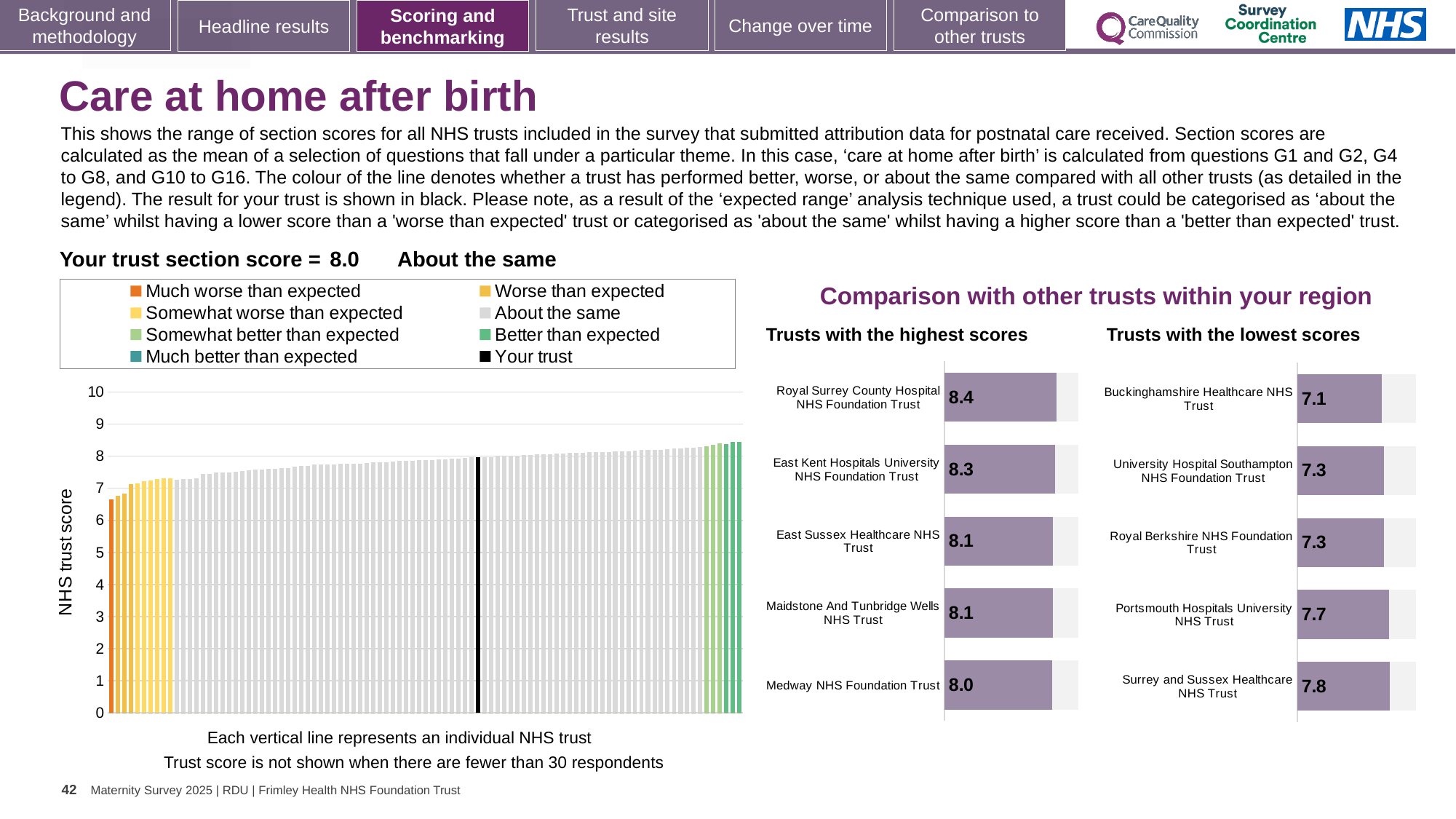
In the 'Trusts with the highest scores' chart, which trust has the lowest score? Medway NHS Foundation Trust In the large 'NHS trust score' chart on the left, do the trust scores rise or fall from left to right? Rise In the 'Trusts with the lowest scores' chart, what is the score for Buckinghamshire Healthcare NHS Trust? 7.1 How many entries does the legend above the large 'NHS trust score' chart list? 8 In the large 'NHS trust score' chart on the left, what kind of chart is it? Bar chart In the 'Trusts with the highest scores' chart, how many trusts are shown? 5 In the 'Trusts with the lowest scores' chart, what is the difference between the scores of Surrey and Sussex Healthcare NHS Trust and Buckinghamshire Healthcare NHS Trust? 0.7 In the large 'NHS trust score' chart on the left, is the value of the black bar (your trust) greater or less than 7? greater In the 'Trusts with the highest scores' chart, what is the difference between the scores of Royal Surrey County Hospital NHS Foundation Trust and Medway NHS Foundation Trust? 0.4 In the 'Trusts with the lowest scores' chart, which has the larger score: Portsmouth Hospitals University NHS Trust or University Hospital Southampton NHS Foundation Trust? Portsmouth Hospitals University NHS Trust In the 'Trusts with the highest scores' chart, what is the score for Royal Surrey County Hospital NHS Foundation Trust? 8.4 In the 'Trusts with the lowest scores' chart, which trust has the highest score? Surrey and Sussex Healthcare NHS Trust